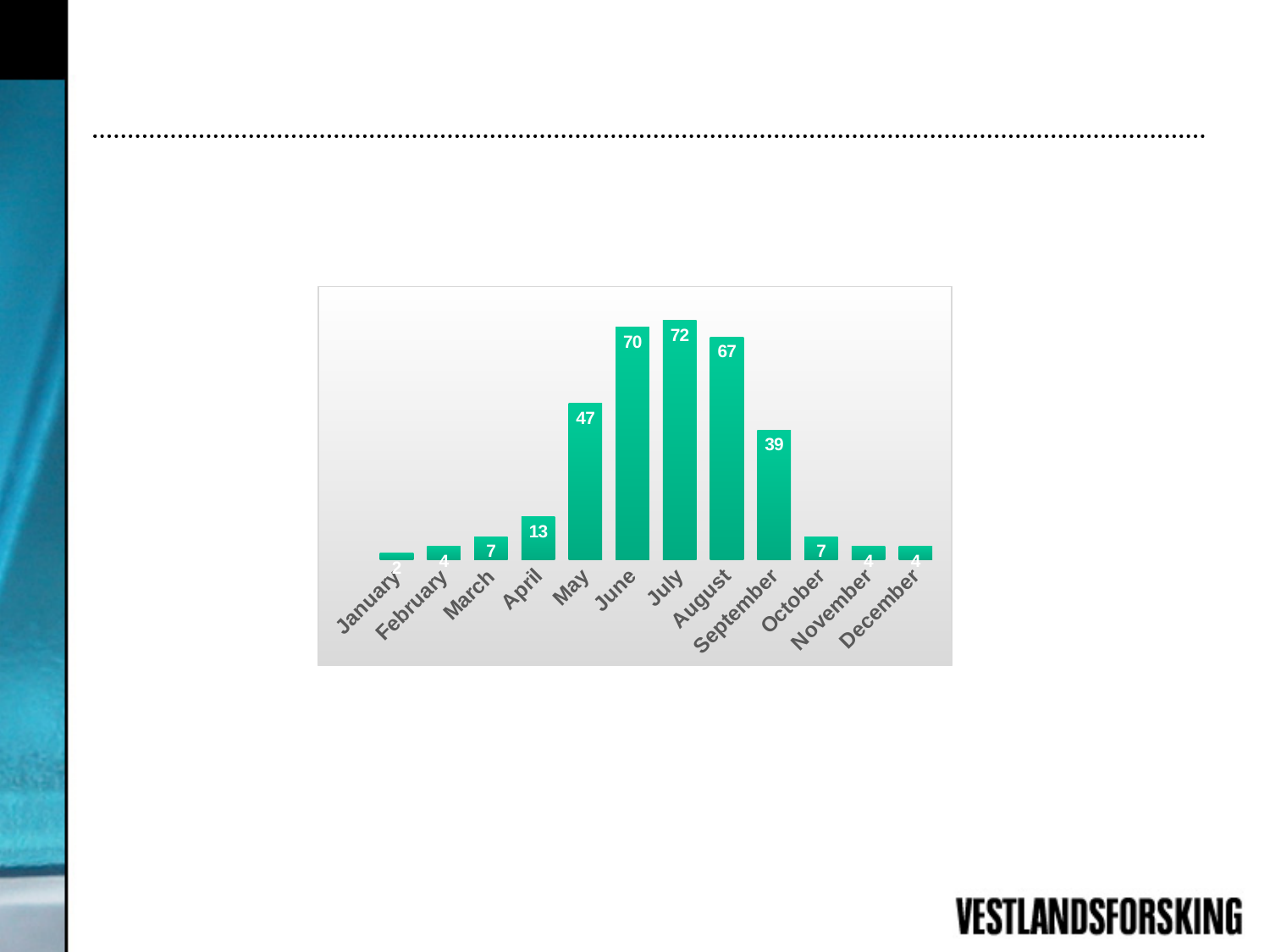
What is the difference between the values for July and August? 5 What is the value for April? 13 What is the value for June? 70 Do the values rise or fall from May to July? rise What is the value for September? 39 What is the value for July? 72 What kind of chart is shown on the slide? bar chart What is the value for May? 47 How many months are shown on the x axis of the chart? 12 Which month has the highest value in the chart? July What is the difference between the values for May and September? 8 Which is larger, the value for June or the value for August? June